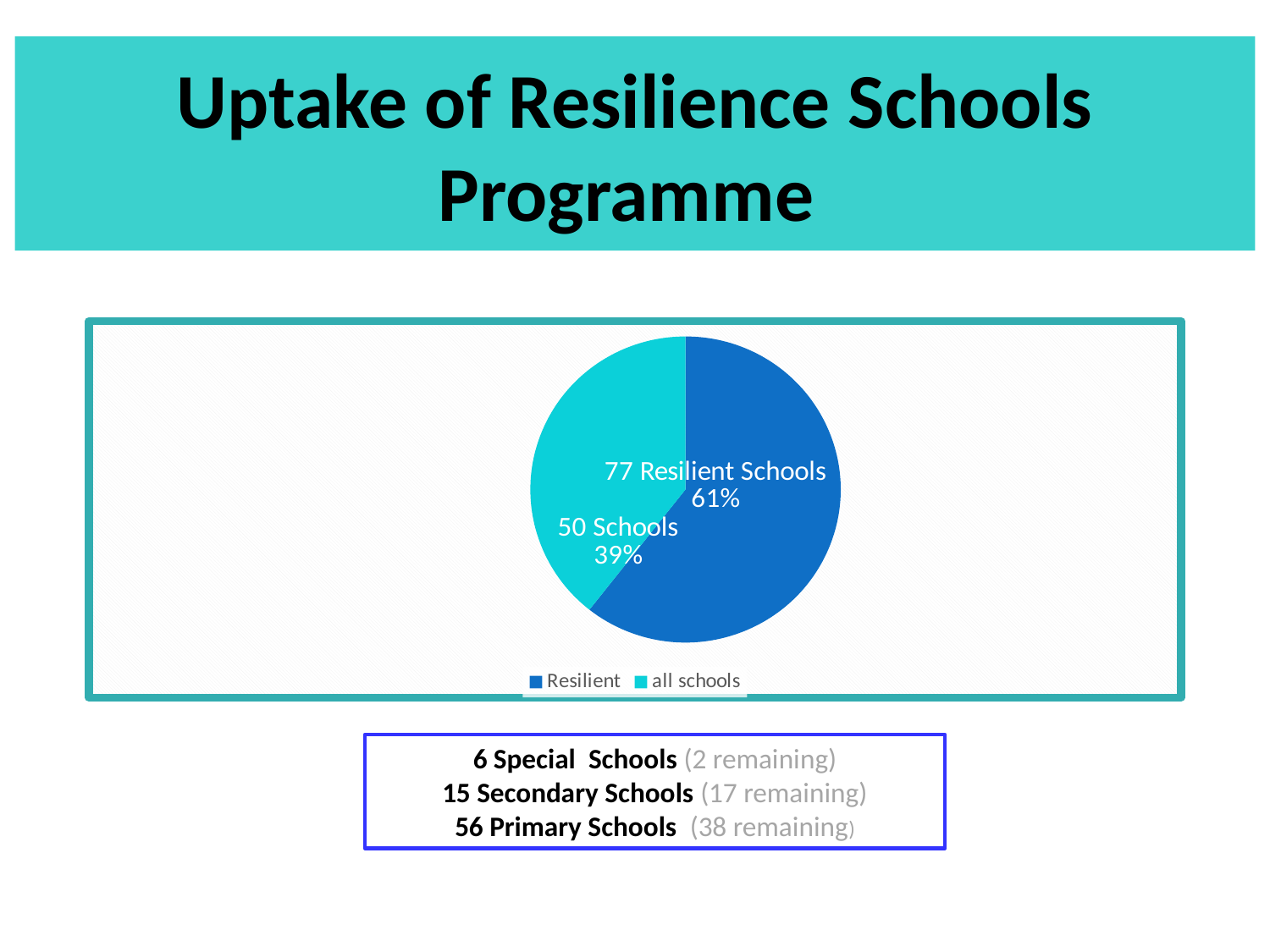
How many entries does the legend list? 2 Which slice of the pie is the largest? Resilient What percentage of the pie does the 'all schools' slice represent? 39% How many slices does the pie chart have? 2 How many schools are shown in the Resilient slice? 77 How many schools are shown in the 'all schools' slice? 50 Which slice of the pie is the smallest? all schools What percentage of the pie does the Resilient slice represent? 61% What is the difference in number of schools between the Resilient slice and the 'all schools' slice? 27 What colour is the Resilient slice in the pie chart? blue What kind of chart is shown on the slide? pie chart Which slice is larger, Resilient or all schools? Resilient